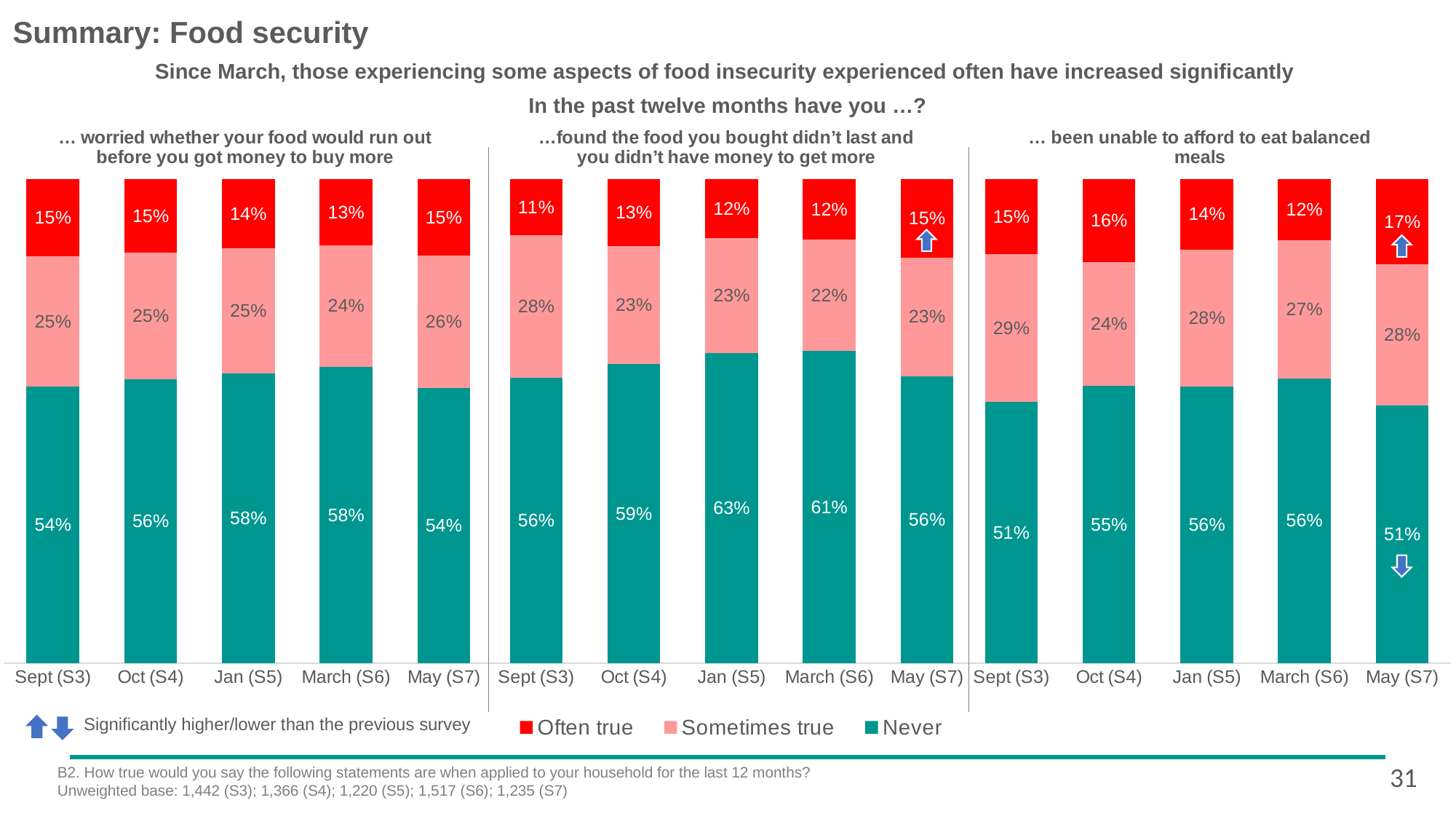
In the right chart (unable to afford to eat balanced meals), what is the difference between the 'Often true' values for May (S7) and March (S6)? 5 percentage points In the middle chart (found the food you bought didn't last), what is the total of the stacked bar for Oct (S4)? 95% Which series is shown in red in the legend? Often true In the middle chart (found the food you bought didn't last), what is the 'Often true' value for May (S7)? 15% In the right chart (unable to afford to eat balanced meals), what is the 'Sometimes true' value for Sept (S3)? 29% How many survey waves are shown on the x axis of each chart? 5 In the middle chart (found the food you bought didn't last), which survey wave has the highest 'Never' value? Jan (S5) In the right chart (unable to afford to eat balanced meals), which survey wave has the lowest 'Often true' value? March (S6) In the left chart (worried whether your food would run out), is the 'Never' value higher in Oct (S4) or May (S7)? Oct (S4) How many series does the legend list? 3 What type of chart is used on this slide? Stacked bar chart In the left chart (worried whether your food would run out), what percentage answered 'Never' in Jan (S5)? 58%